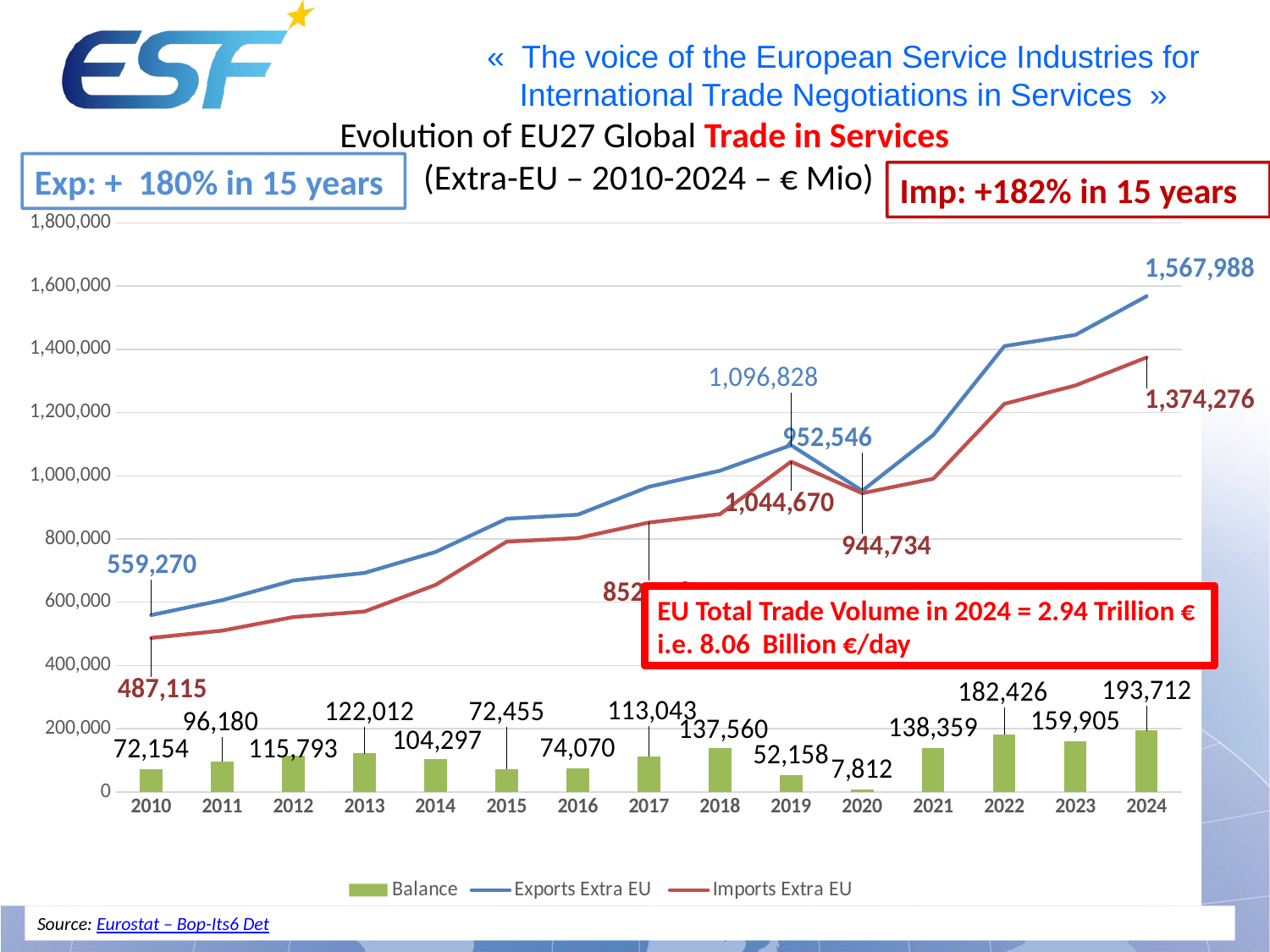
Which is larger: Exports Extra EU in 2019 or Exports Extra EU in 2020? 2019 In which year is the Balance bar highest? 2024 What is the value of Exports Extra EU in 2024? 1,567,988 How many years are shown on the x axis of the chart? 15 Is the value of Exports Extra EU in 2015 greater or less than 800,000? greater What is the difference between Exports Extra EU and Imports Extra EU in 2024? 193,712 What is the Balance value for 2020? 7,812 What is the difference between the Balance in 2024 and the Balance in 2023? 33,807 What kind of chart is shown on the slide? Combined bar and line chart How many series does the chart legend list? 3 What is the value of Imports Extra EU in 2024? 1,374,276 In which year is the Balance bar lowest? 2020